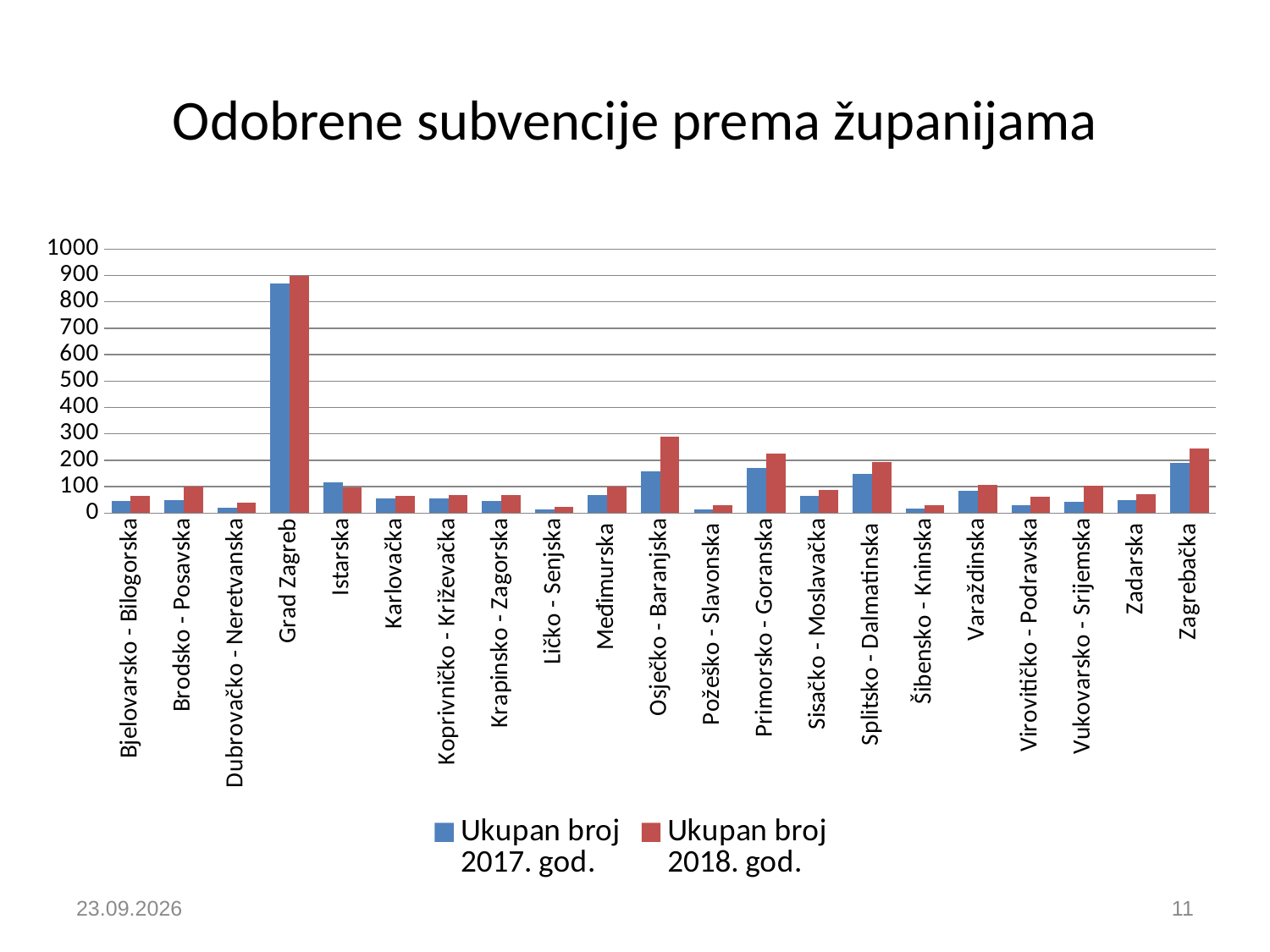
Which county has the highest value for Ukupan broj 2018. god.? Grad Zagreb Is the value for Grad Zagreb in Ukupan broj 2017. god. greater or less than 800? greater Is the value for Istarska in Ukupan broj 2018. god. greater or less than 200? less Is the value for Osječko - Baranjska in Ukupan broj 2018. god. greater or less than 200? greater For Osječko - Baranjska, which is larger: Ukupan broj 2017. god. or Ukupan broj 2018. god.? Ukupan broj 2018. god. How many counties (categories) are shown on the x axis? 21 What kind of chart is shown on the slide? bar chart In Ukupan broj 2018. god., which is larger: Osječko - Baranjska or Zagrebačka? Osječko - Baranjska How many series does the legend list? 2 Which county has the highest value for Ukupan broj 2017. god.? Grad Zagreb What is the title of the chart? Odobrene subvencije prema županijama